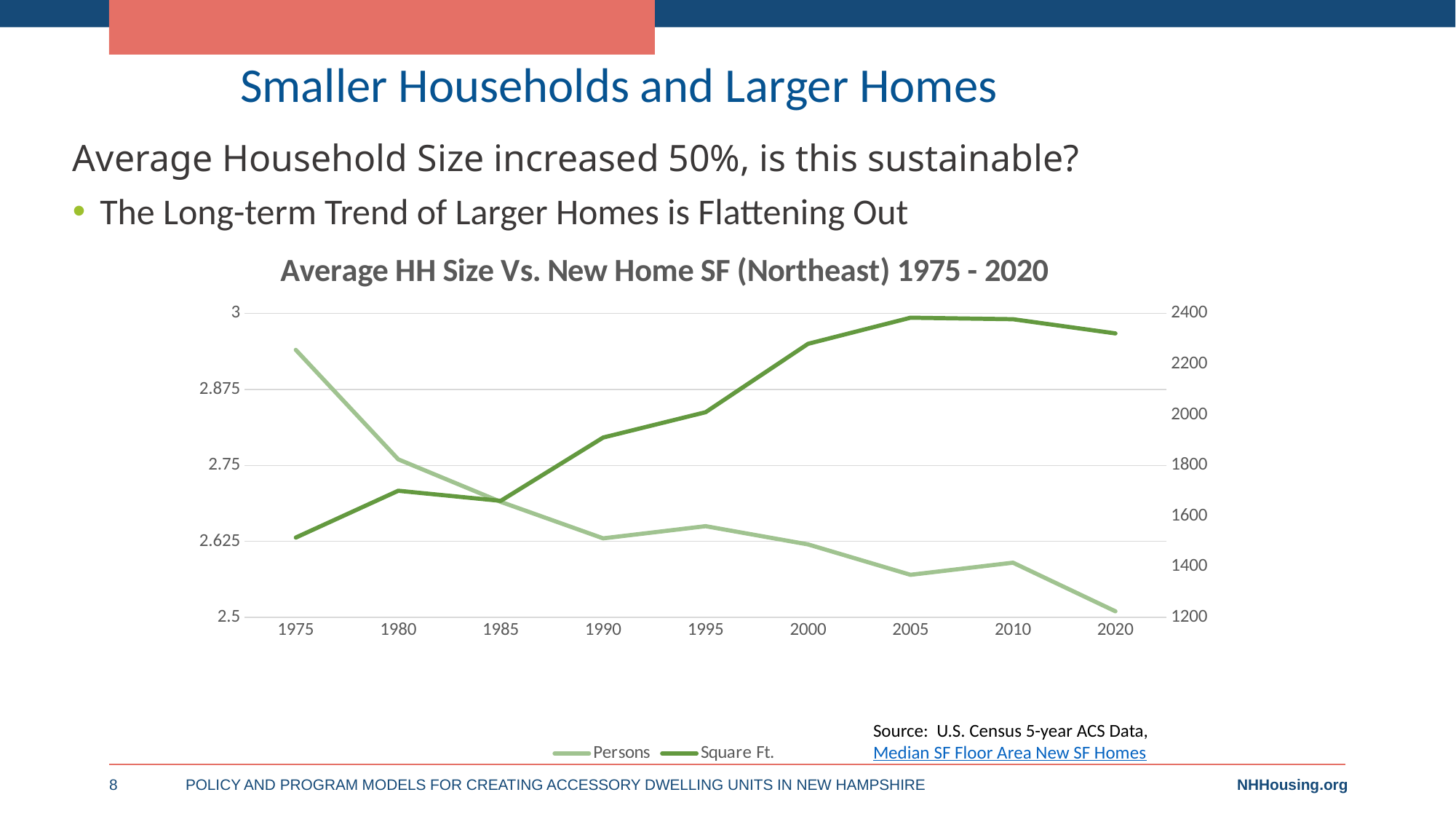
Does the Persons series generally rise or fall from 1975 to 2020? Fall What kind of chart is shown on the slide? Line chart How many years are labelled along the x axis of the chart? 9 How many series does the chart legend list? 2 In which year is the Square Ft. series at its lowest? 1975 Which is larger, the Persons value for 1980 or for 1990? 1980 Is the Persons value for 1975 greater or less than 2.875? greater What is the title of the chart? Average HH Size Vs. New Home SF (Northeast) 1975 - 2020 In which year is the Persons series at its lowest? 2020 Is the Square Ft. value for 2005 greater or less than 2200? greater Which series does the darker green line represent? Square Ft. In which year is the Persons series at its highest? 1975